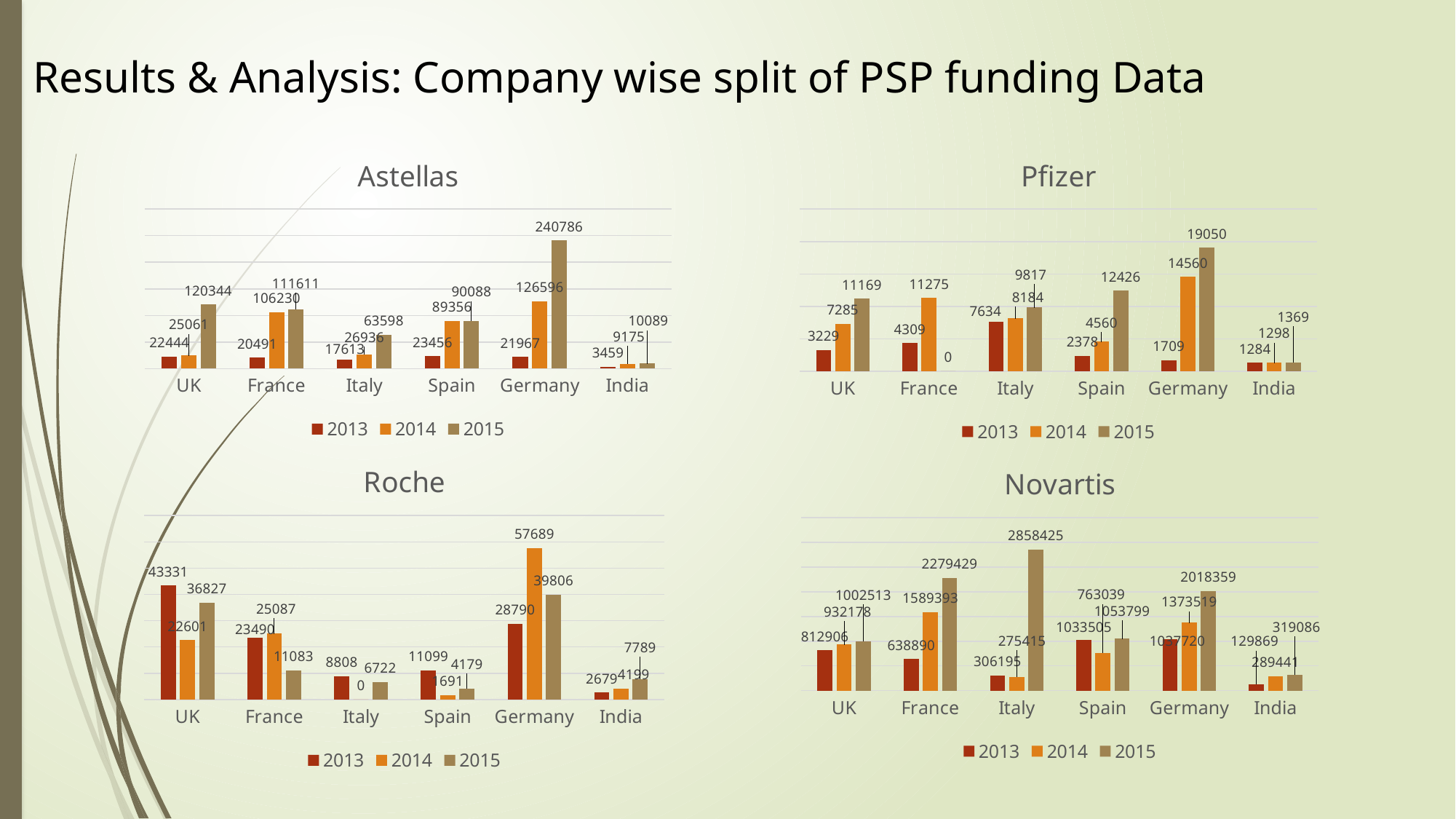
In the Astellas chart, what is the value for Germany in 2015? 240786 What kind of chart is the Roche chart? bar chart How many countries are shown on the x axis of the Novartis chart? 6 In the Roche chart, which year has the highest value for the UK? 2013 In the Astellas chart, what is the difference between the 2015 and 2014 values for Germany? 114190 In the Pfizer chart, what is the value for France in 2015? 0 How many series does the legend of the Pfizer chart list? 3 In the Roche chart, what is the value for Italy in 2014? 0 In the Pfizer chart, which country has the highest value for 2015? Germany In the Roche chart, which is larger: Germany in 2014 or the UK in 2013? Germany in 2014 In the Novartis chart, what is the value for Italy in 2015? 2858425 In the Astellas chart, which country has the lowest value for 2013? India